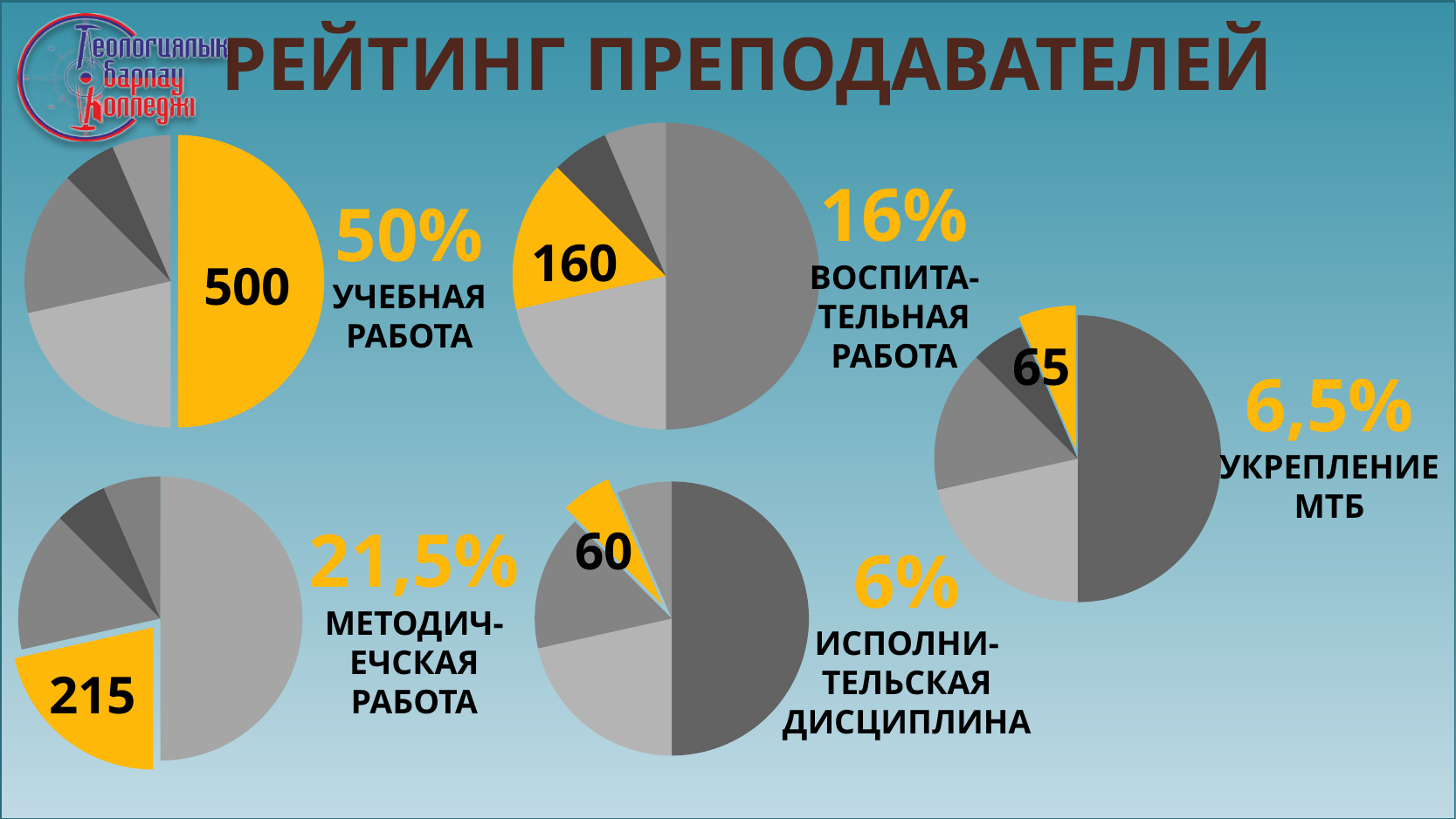
What share of the pie does the highlighted slice for УЧЕБНАЯ РАБОТА represent? 50% What value is labelled on the highlighted slice of the pie chart for УКРЕПЛЕНИЕ МТБ? 65 What value is labelled on the highlighted slice of the pie chart for ВОСПИТАТЕЛЬНАЯ РАБОТА? 160 Which category has the largest highlighted value among the five pie charts? УЧЕБНАЯ РАБОТА How many pie charts are shown on the slide? 5 What share of the pie does the highlighted slice for УКРЕПЛЕНИЕ МТБ represent? 6,5% What is the difference between the highlighted values for УЧЕБНАЯ РАБОТА and ВОСПИТАТЕЛЬНАЯ РАБОТА? 340 What kind of charts are shown on the slide? Pie charts What share of the pie does the highlighted slice for МЕТОДИЧЕСКАЯ РАБОТА represent? 21,5% What value is labelled on the highlighted slice of the pie chart for ИСПОЛНИТЕЛЬСКАЯ ДИСЦИПЛИНА? 60 What value is labelled on the highlighted slice of the pie chart for МЕТОДИЧЕСКАЯ РАБОТА? 215 What value is labelled on the highlighted slice of the pie chart for УЧЕБНАЯ РАБОТА? 500